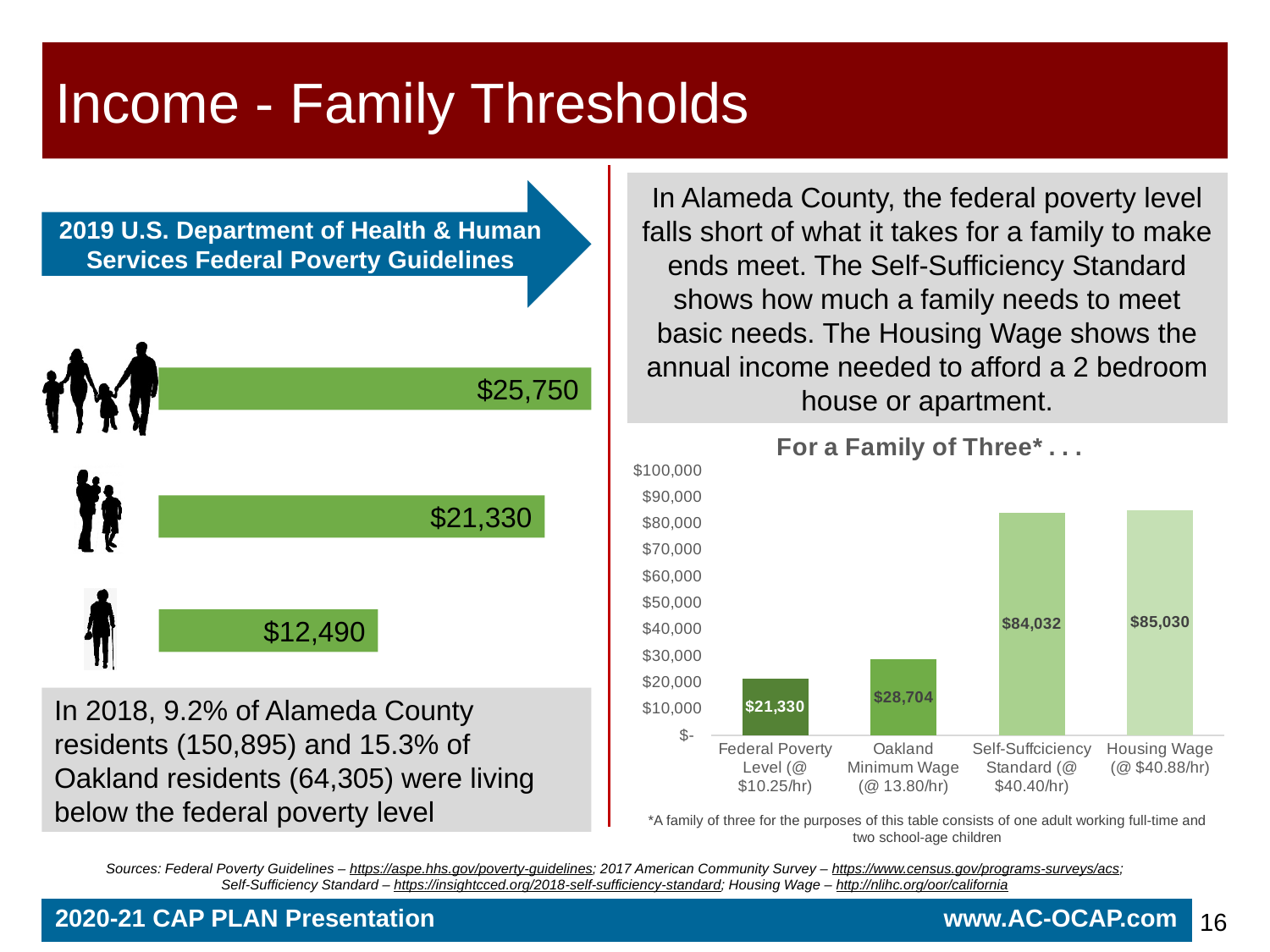
In the chart 'For a Family of Three', which is larger: the Self-Sufficiency Standard or the Oakland Minimum Wage? Self-Sufficiency Standard In the chart 'For a Family of Three', what is the difference between the Oakland Minimum Wage and the Federal Poverty Level values? $7,374 In the chart 'For a Family of Three', what is the value for Housing Wage? $85,030 In the chart 'For a Family of Three', what is the value for Self-Sufficiency Standard? $84,032 What type of chart is 'For a Family of Three'? bar chart In the chart 'For a Family of Three', which category has the lowest value? Federal Poverty Level How many categories are shown in the chart 'For a Family of Three'? 4 In the chart 'For a Family of Three', is the value for Oakland Minimum Wage greater or less than $30,000? less In the chart 'For a Family of Three', which category has the highest value? Housing Wage In the chart 'For a Family of Three', what is the difference between the Housing Wage and the Self-Sufficiency Standard values? $998 In the chart 'For a Family of Three', what is the value for Federal Poverty Level? $21,330 In the chart 'For a Family of Three', what is the value for Oakland Minimum Wage? $28,704